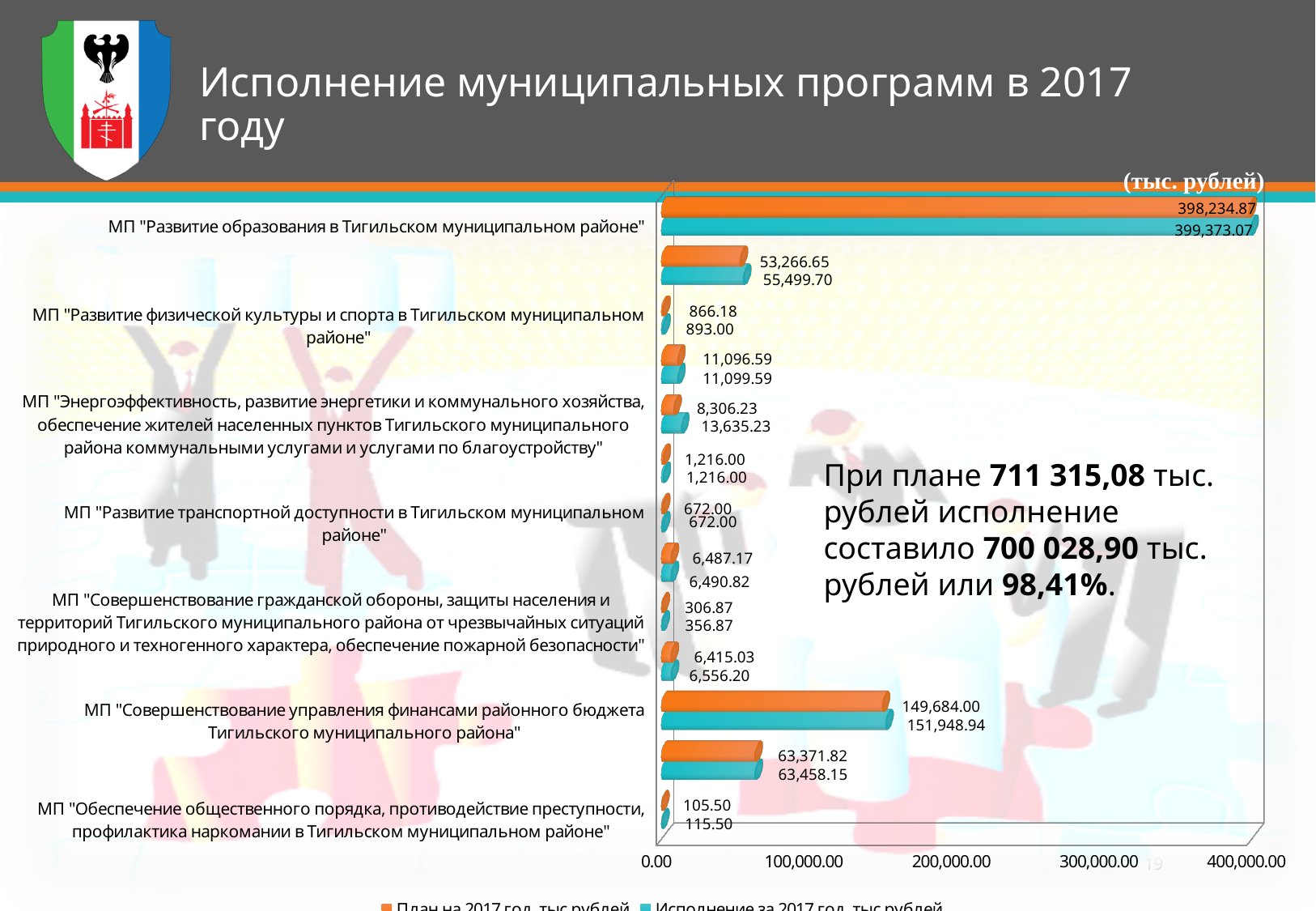
For МП "Развитие физической культуры и спорта в Тигильском муниципальном районе", which is larger: the plan value or the execution value? the execution value (893.00) What is the execution value (Исполнение за 2017 год) for МП "Совершенствование гражданской обороны, защиты населения и территорий Тигильского муниципального района от чрезвычайных ситуаций..."? 356.87 In what units are the chart values given, according to the note above the chart? тыс. рублей Which program has the highest plan value (План на 2017 год)? МП "Развитие образования в Тигильском муниципальном районе" What is the execution value (Исполнение за 2017 год) for МП "Совершенствование управления финансами районного бюджета Тигильского муниципального района"? 151,948.94 What is the plan value (План на 2017 год) for МП "Развитие образования в Тигильском муниципальном районе"? 398,234.87 How many series does the chart's legend list? 2 What is the execution value (Исполнение за 2017 год) for МП "Развитие образования в Тигильском муниципальном районе"? 399,373.07 What kind of chart is shown on the slide? bar chart For МП "Энергоэффективность, развитие энергетики и коммунального хозяйства...", how much larger is the execution value than the plan value? 5,329.00 What is the plan value (План на 2017 год) for МП "Обеспечение общественного порядка, противодействие преступности, профилактика наркомании в Тигильском муниципальном районе"? 105.50 Is the plan value for МП "Совершенствование управления финансами районного бюджета Тигильского муниципального района" greater or less than 100,000.00? greater